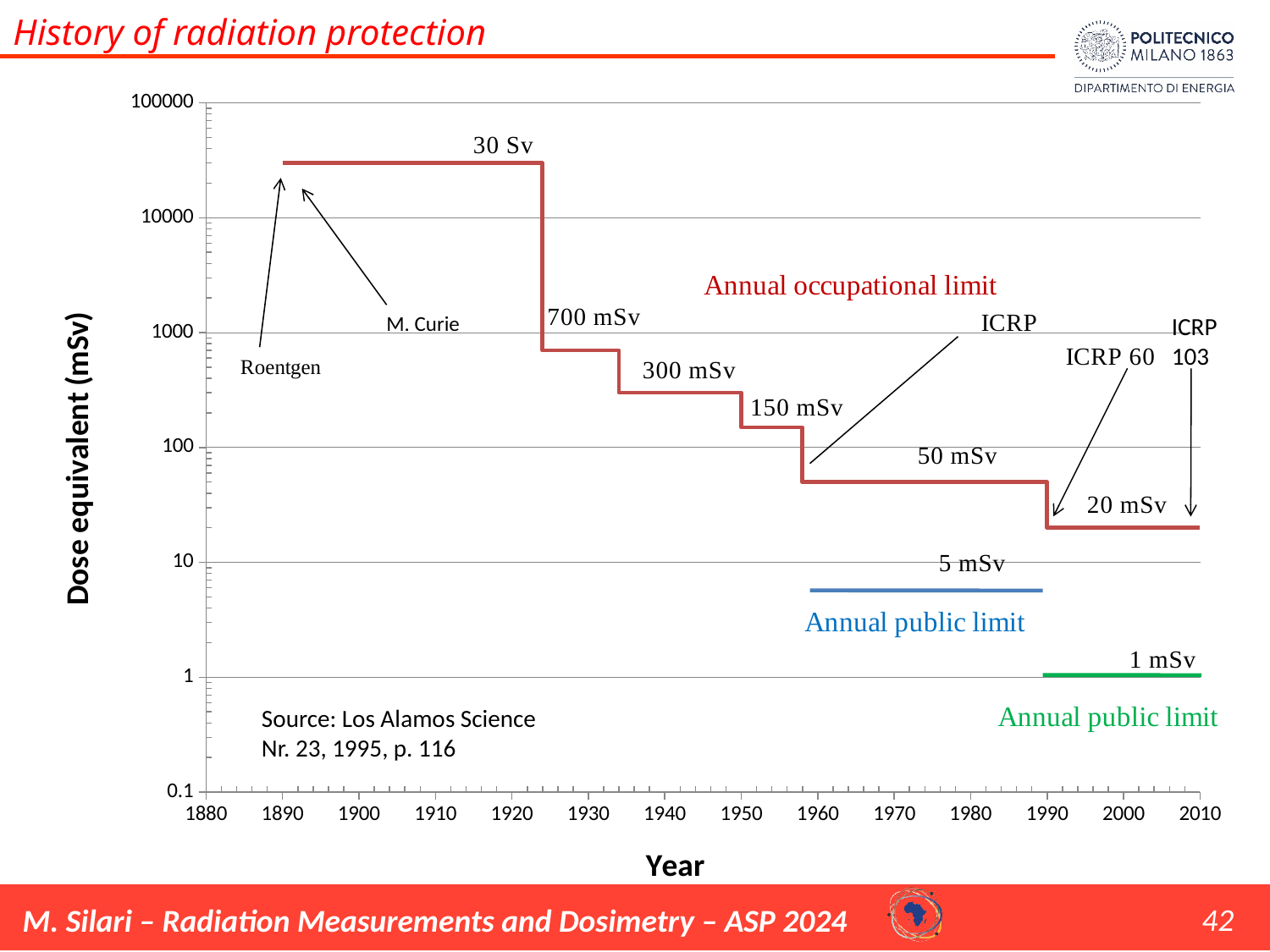
What is the label of the y axis? Dose equivalent (mSv) What is the annual public limit shown by the blue line? 5 mSv What kind of chart is shown on the slide? Line chart How many distinct annual occupational limit values are labelled on the red line? 6 Does the annual occupational limit rise or fall over the years shown? Fall What annual occupational limit is labelled for the step between about 1934 and 1950? 300 mSv What is the annual occupational limit shown for the period starting around 1990? 20 mSv What is the difference between the 50 mSv and 20 mSv occupational limit steps? 30 mSv Which is larger, the occupational limit labelled 150 mSv or the one labelled 50 mSv? 150 mSv What is the highest annual occupational limit value labelled on the chart? 30 Sv What is the difference between the 700 mSv and 300 mSv occupational limit steps? 400 mSv What is the lowest annual public limit value labelled on the chart? 1 mSv